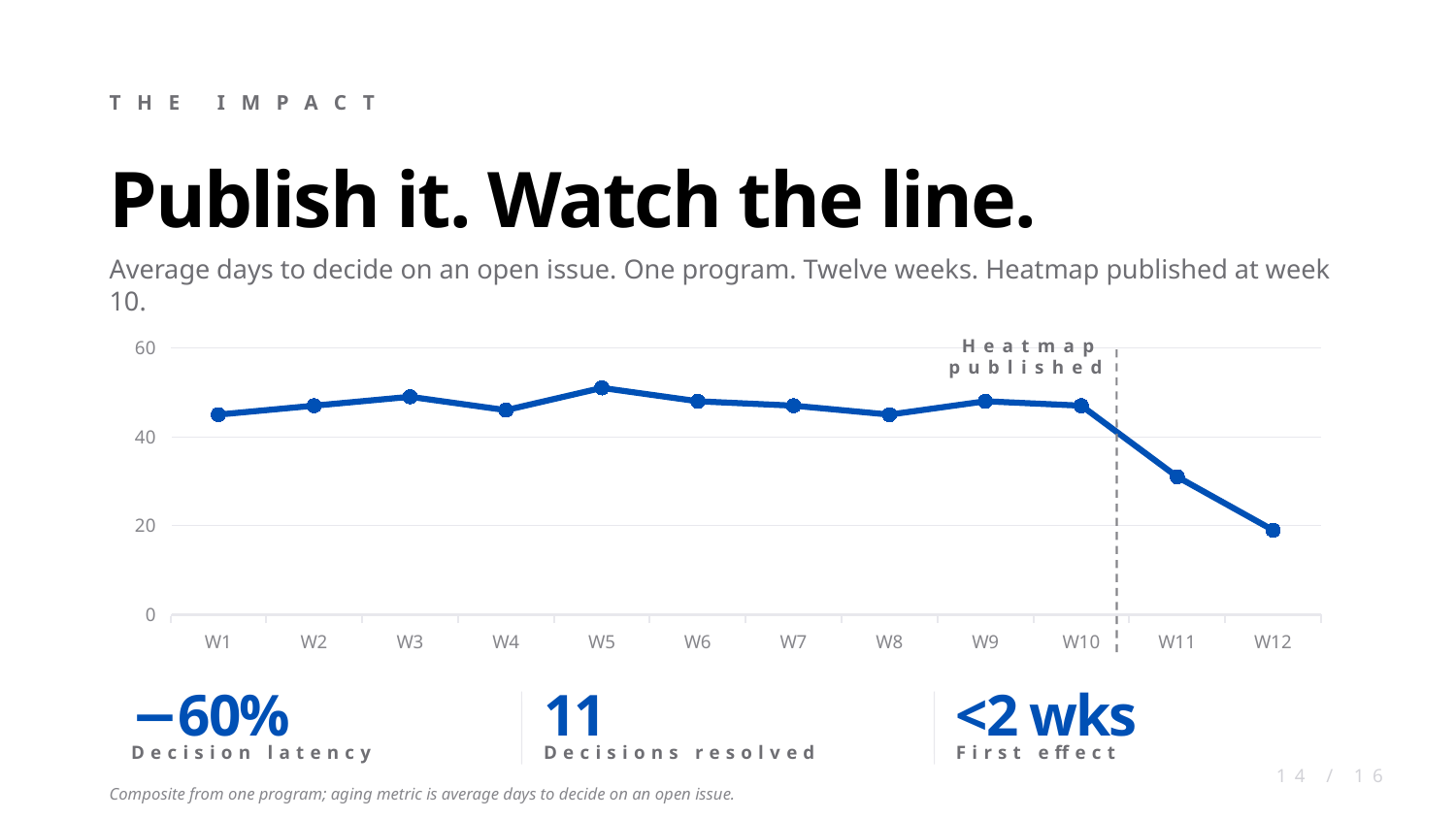
Which is larger, the value for W10 or the value for W11? W10 Is the value for W1 greater or less than 40? greater Is the value for W11 greater or less than 40? less How many weekly data points are plotted on the chart? 12 Which is larger, the value for W11 or the value for W12? W11 Is the value for W11 greater or less than 20? greater What kind of chart is shown on the slide? line chart Do the values rise or fall from W10 to W12? fall Which week has the lowest value on the chart? W12 What does the annotation next to the dashed vertical line on the chart say? Heatmap published